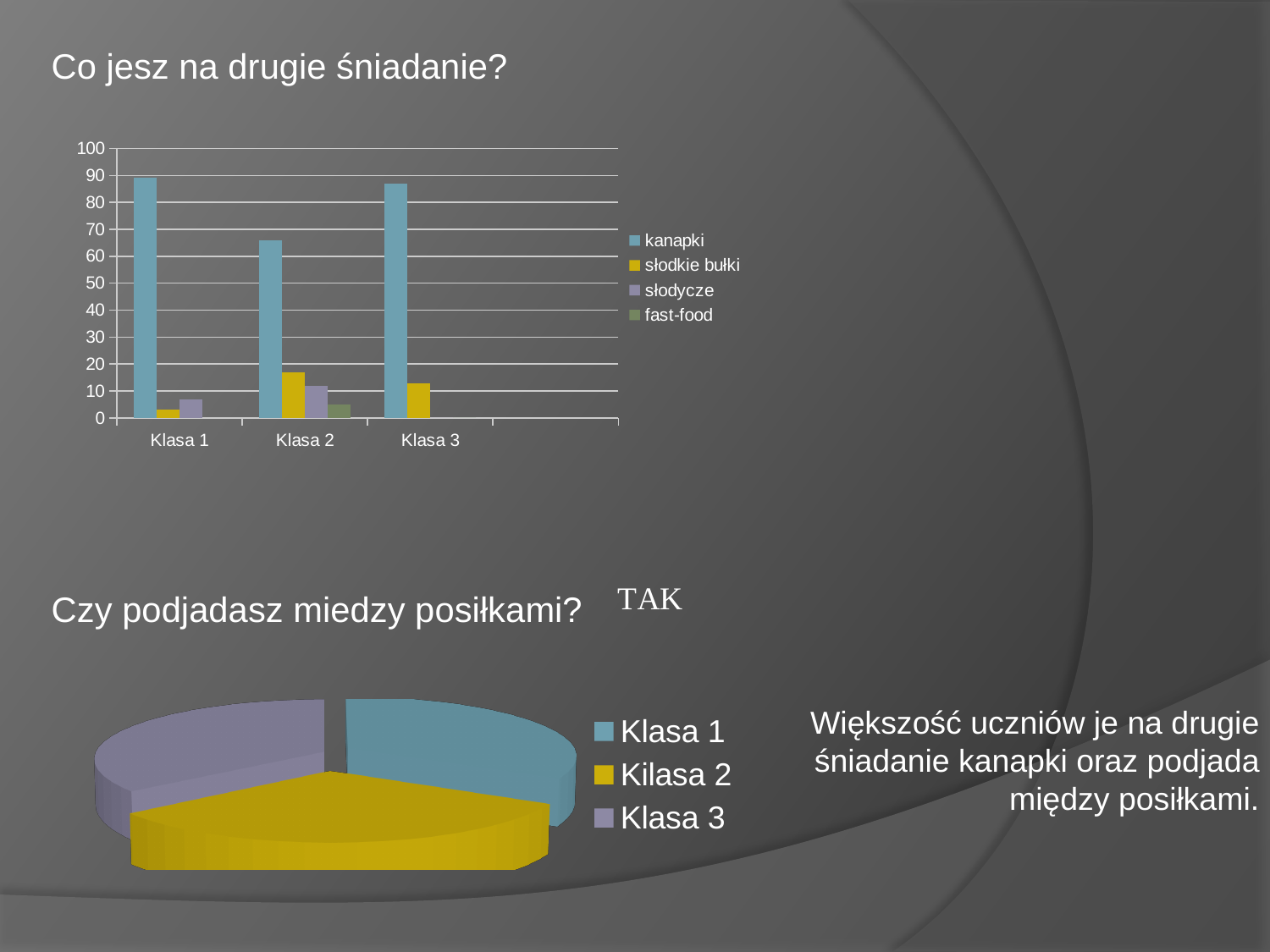
In the top bar chart, is the value of kanapki for Klasa 1 greater or less than 80? greater In the top bar chart, is the value of słodkie bułki for Klasa 2 greater or less than 10? greater In the top bar chart, is the value of kanapki for Klasa 2 greater or less than 70? less In the top bar chart, which is larger: kanapki for Klasa 1 or kanapki for Klasa 2? kanapki for Klasa 1 In the bottom pie chart, how many slices are there? 3 In the top bar chart, which series has the highest value for Klasa 2? kanapki In the top bar chart, how many series does the legend list? 4 What kind of chart is the top chart, 'Co jesz na drugie śniadanie?'? bar chart In the top bar chart, which category has the lowest value for kanapki? Klasa 2 What is the title of the top bar chart? Co jesz na drugie śniadanie? What kind of chart is the bottom chart, 'Czy podjadasz miedzy posiłkami?'? pie chart In the top bar chart, how many categories are shown on the x axis? 3